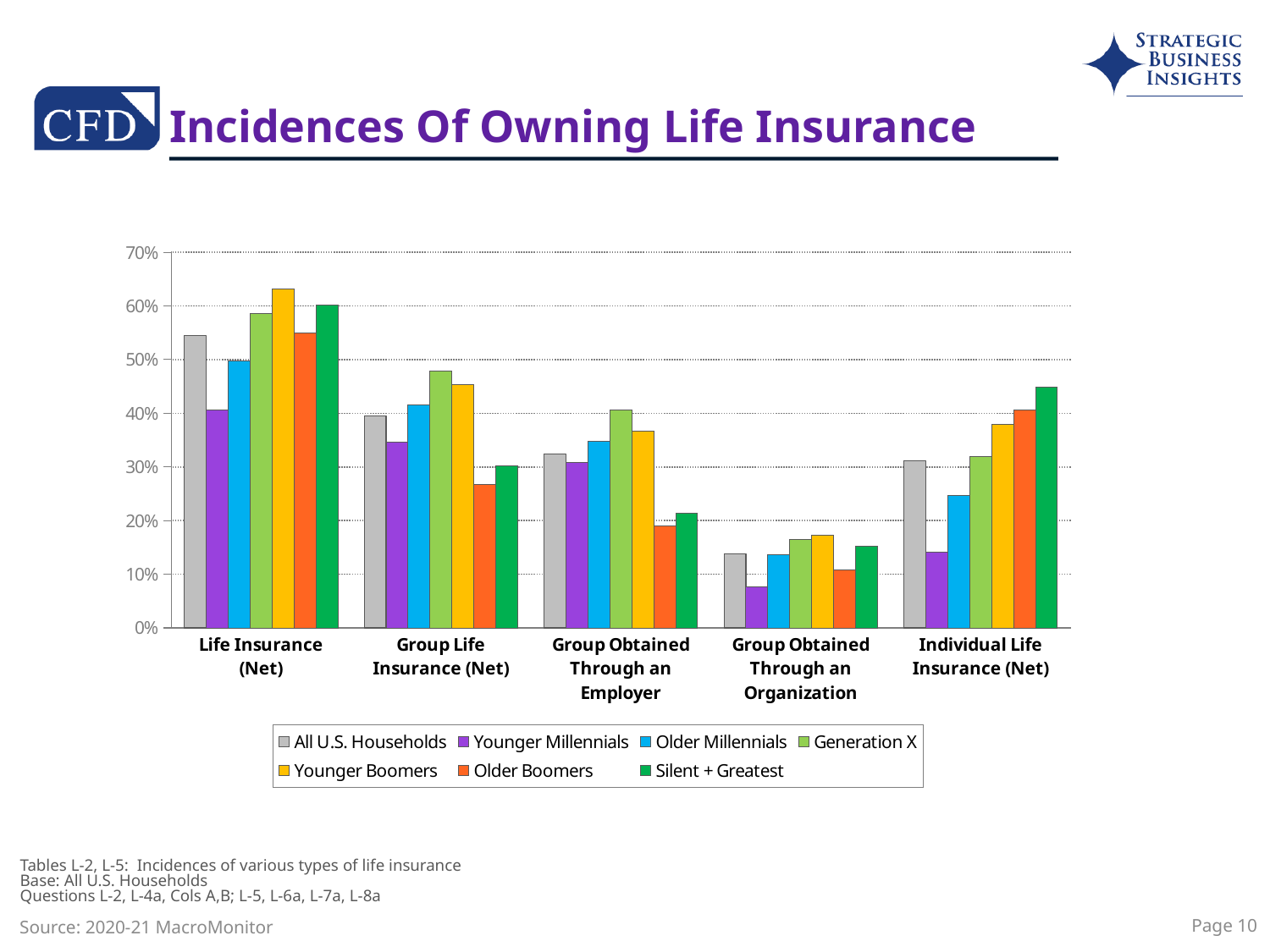
Is the value for Younger Boomers in Life Insurance (Net) greater or less than 60%? greater Which group has the lowest value for Group Obtained Through an Organization? Younger Millennials Is the value for Younger Millennials in Individual Life Insurance (Net) greater or less than 20%? less Which group has the highest value for Life Insurance (Net)? Younger Boomers What kind of chart is shown on the slide? Bar chart How many series does the legend list? 7 Which group has the lowest value for Group Life Insurance (Net)? Older Boomers Is the value for Older Boomers in Group Life Insurance (Net) greater or less than 30%? less For Group Obtained Through an Employer, which is larger: Generation X or Older Boomers? Generation X Which group has the highest value for Individual Life Insurance (Net)? Silent + Greatest What is the title of the chart on the slide? Incidences Of Owning Life Insurance How many insurance categories are shown along the x axis? 5